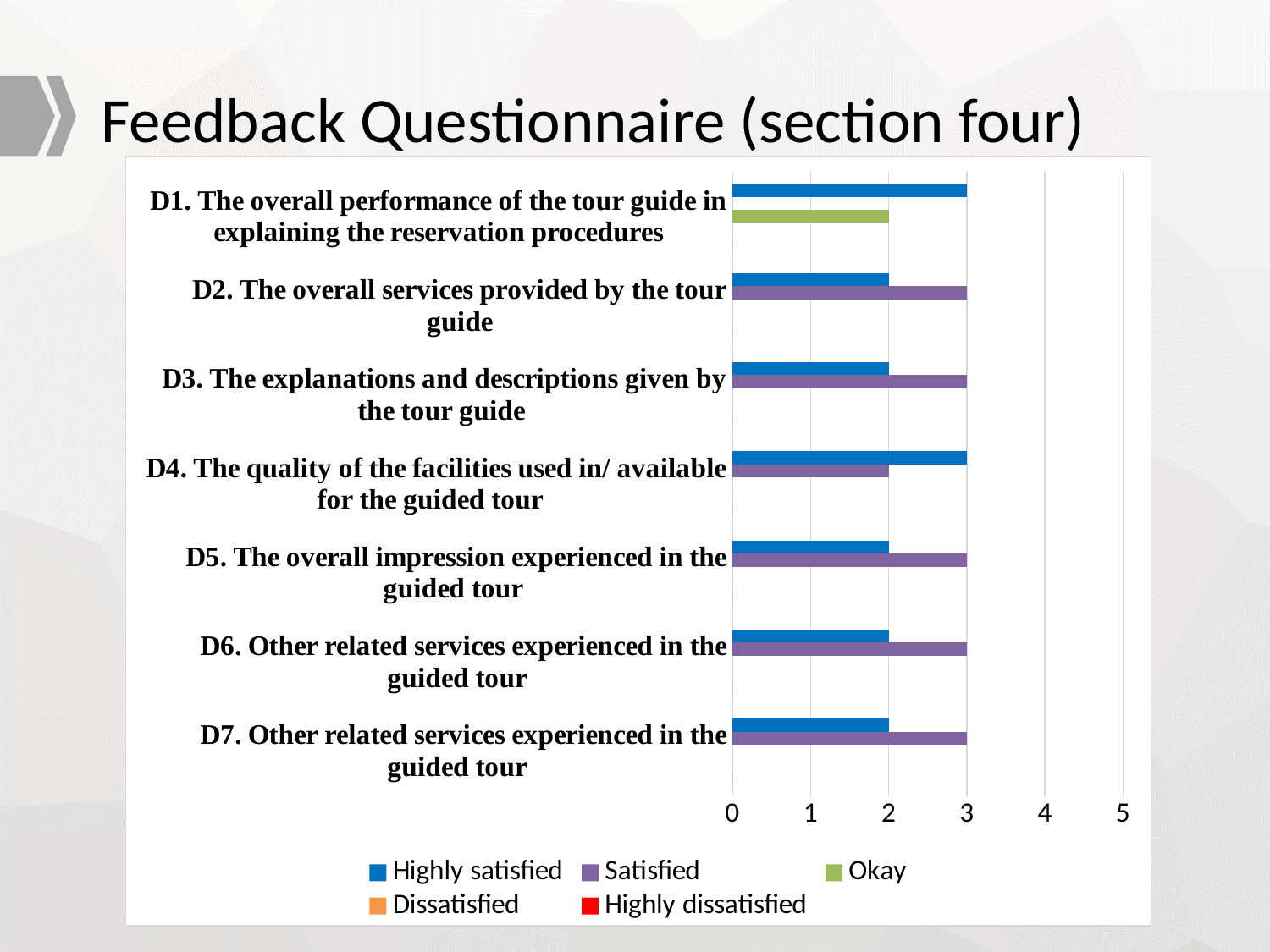
How many categories (questionnaire items) are plotted on the chart? 7 What is the Okay value for D1? 2 Which category is the only one with an Okay bar? D1 What kind of chart is shown on the slide? bar chart What is the Highly satisfied value for D4 (the quality of the facilities used in/available for the guided tour)? 3 What is the difference between the Satisfied value and the Highly satisfied value for D7? 1 What is the Satisfied value for D4? 2 What is the Satisfied value for D2 (the overall services provided by the tour guide)? 3 How many series does the legend list? 5 What is the maximum value shown on the horizontal axis? 5 For D5, which is larger: the Highly satisfied value or the Satisfied value? Satisfied What is the Highly satisfied value for D1 (the overall performance of the tour guide in explaining the reservation procedures)? 3